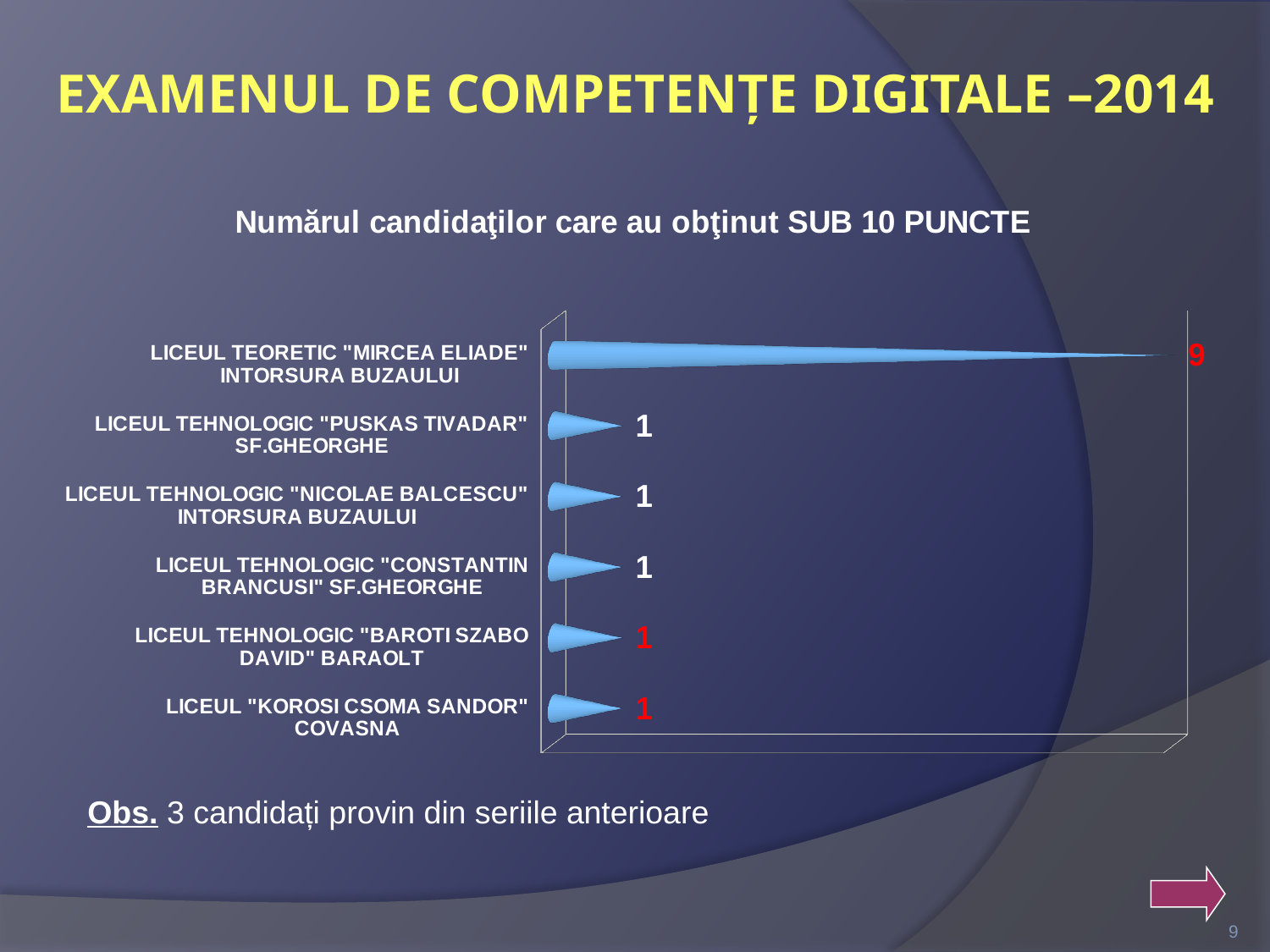
What is the total of all values shown in the chart? 14 Which category has the highest value? LICEUL TEORETIC "MIRCEA ELIADE" INTORSURA BUZAULUI What is the title of the chart? Numărul candidaţilor care au obţinut SUB 10 PUNCTE How many categories are shown in the chart? 6 What is the difference between the value for LICEUL TEORETIC "MIRCEA ELIADE" INTORSURA BUZAULUI and the value for LICEUL TEHNOLOGIC "BAROTI SZABO DAVID" BARAOLT? 8 What is the value for LICEUL TEHNOLOGIC "CONSTANTIN BRANCUSI" SF.GHEORGHE? 1 What kind of chart is shown on the slide? bar chart What is the value for LICEUL "KOROSI CSOMA SANDOR" COVASNA? 1 Which is larger: the value for LICEUL TEORETIC "MIRCEA ELIADE" INTORSURA BUZAULUI or the value for LICEUL TEHNOLOGIC "NICOLAE BALCESCU" INTORSURA BUZAULUI? LICEUL TEORETIC "MIRCEA ELIADE" INTORSURA BUZAULUI What is the value for LICEUL TEHNOLOGIC "PUSKAS TIVADAR" SF.GHEORGHE? 1 How many categories have a value of 1? 5 What is the value for LICEUL TEORETIC "MIRCEA ELIADE" INTORSURA BUZAULUI? 9